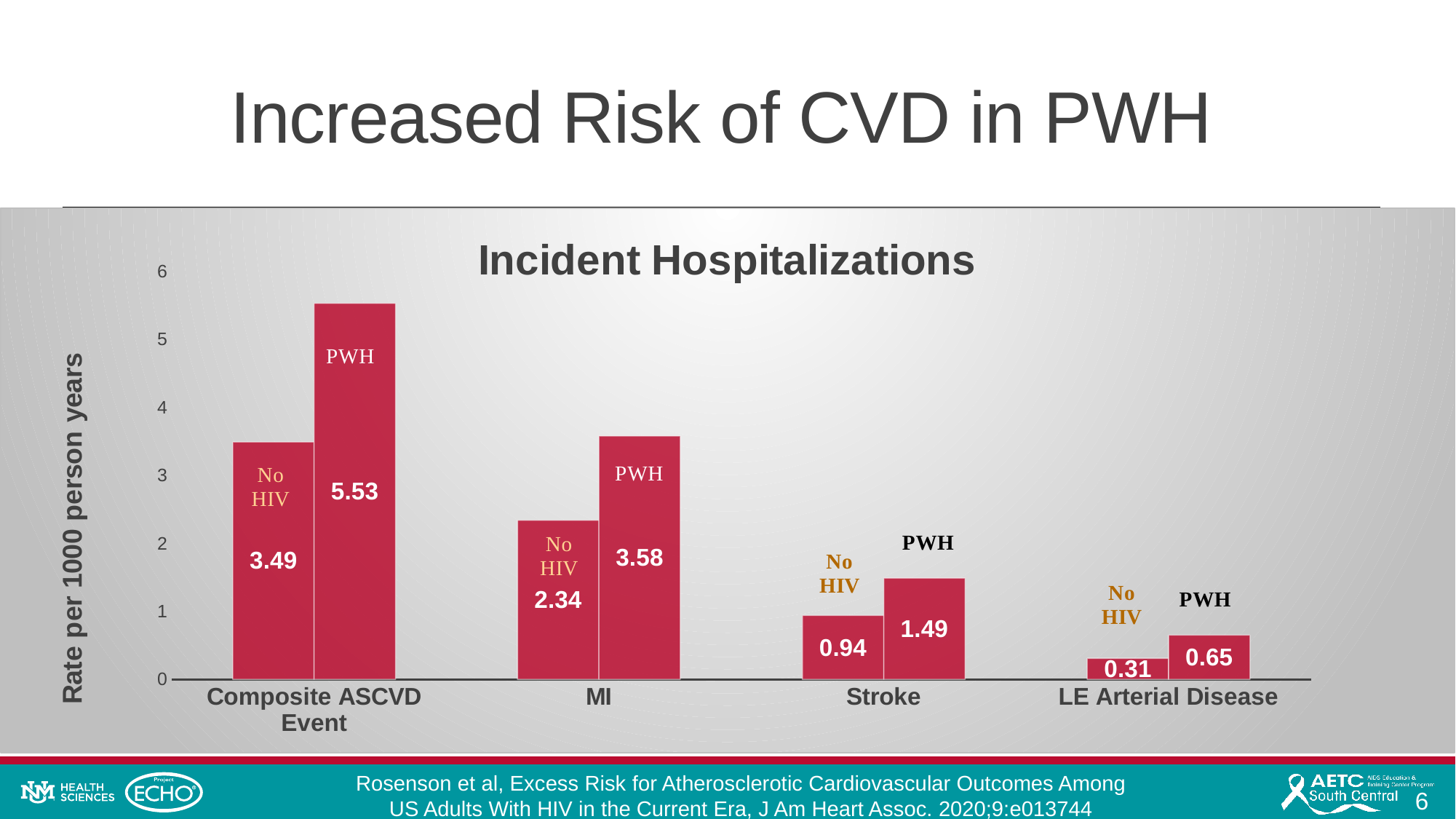
Which category has the lowest No HIV rate? LE Arterial Disease Which is larger for MI, the PWH rate or the No HIV rate? PWH What is the difference between the PWH and No HIV rates for Stroke? 0.55 What is the rate per 1000 person years for PWH for Stroke? 1.49 How many categories are shown on the x axis? 4 What is the difference between the PWH and No HIV rates for Composite ASCVD Event? 2.04 Which category has the highest PWH rate? Composite ASCVD Event What kind of chart is shown on the slide? Bar chart What is the rate per 1000 person years for PWH for Composite ASCVD Event? 5.53 What is the rate per 1000 person years for No HIV for MI? 2.34 What is the title of the chart? Incident Hospitalizations What is the rate per 1000 person years for No HIV for LE Arterial Disease? 0.31